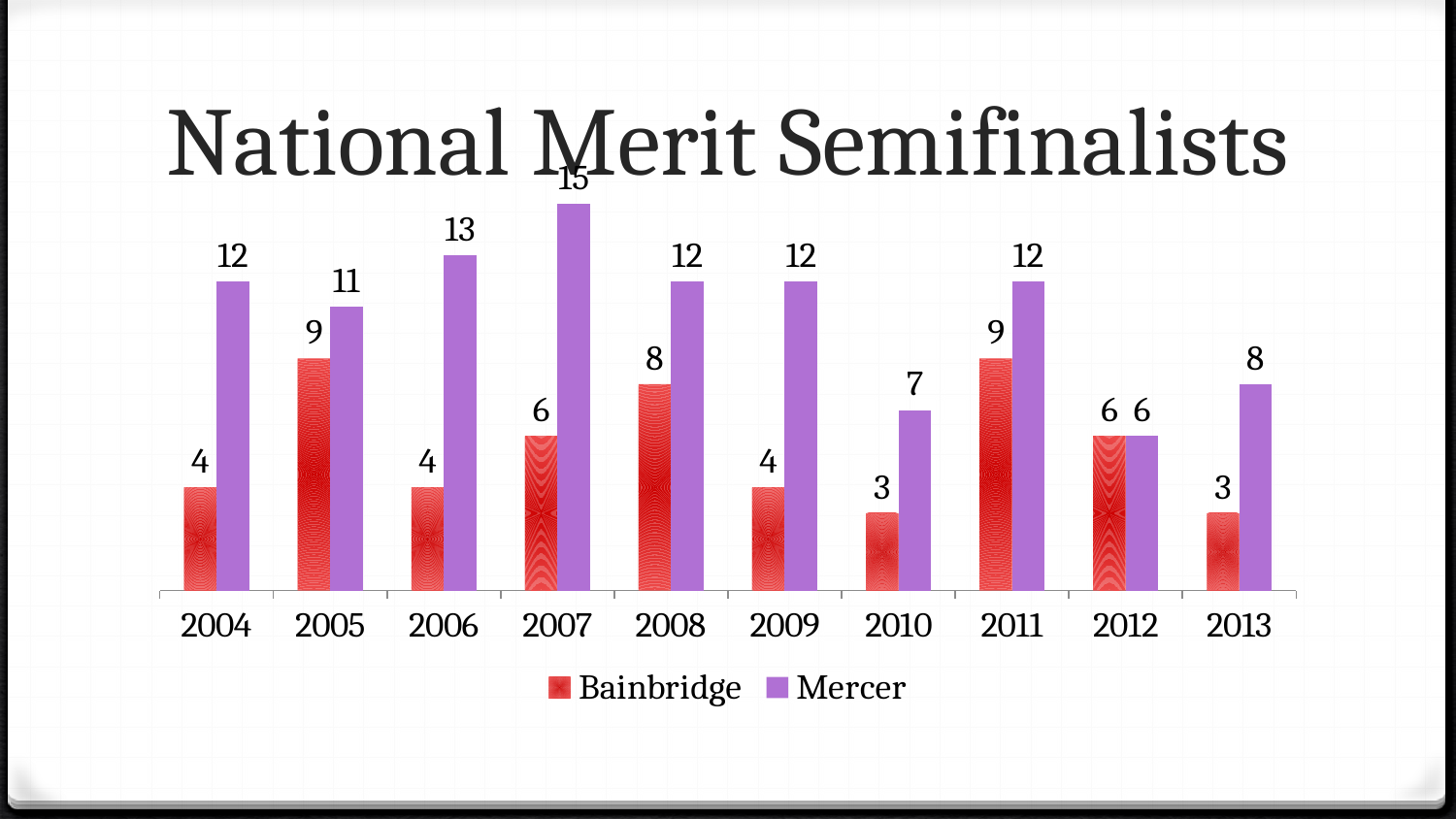
Which colour represents Mercer in the chart? purple Which is larger in 2010, the Bainbridge value or the Mercer value? Mercer What is the value for Mercer in 2007? 15 What is the value for Bainbridge in 2011? 9 In which year is the Mercer value lowest? 2012 In which year is the Mercer value highest? 2007 What is the title of the chart? National Merit Semifinalists How many years are shown on the x axis? 10 How many series does the legend list? 2 What is the value for Bainbridge in 2013? 3 What kind of chart is shown on the slide? bar chart What is the difference between the Mercer and Bainbridge values in 2007? 9